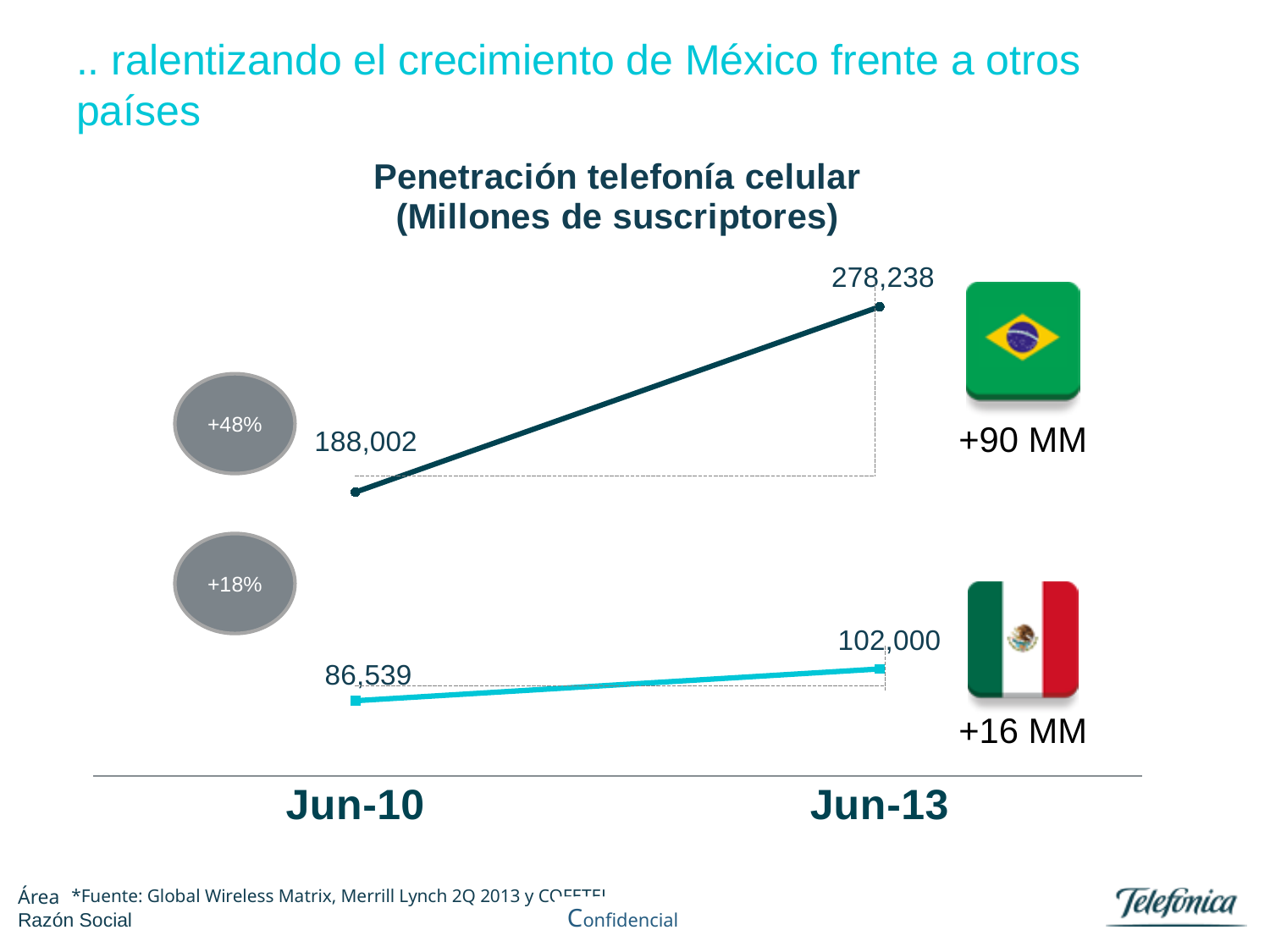
What is the Jun-10 value for the lower line (marked with the Mexican flag)? 86,539 What is the title of the chart? Penetración telefonía celular (Millones de suscriptores) What kind of chart is shown on the slide? line chart What is the Jun-13 value for the lower line (marked with the Mexican flag)? 102,000 What is the Jun-10 value for the upper line (marked with the Brazilian flag)? 188,002 How many time points are shown on the x axis? 2 By how much did the lower line (Mexico) increase from Jun-10 to Jun-13? 15,461 Do the values of the lower line (Mexico) rise or fall from Jun-10 to Jun-13? rise By how much did the upper line (Brazil) increase from Jun-10 to Jun-13? 90,236 What percentage growth is shown in the circle next to the upper line (Brazil)? +48% What is the Jun-13 value for the upper line (marked with the Brazilian flag)? 278,238 Which line has the higher value at Jun-13, the upper line (Brazil) or the lower line (Mexico)? the upper line (Brazil)